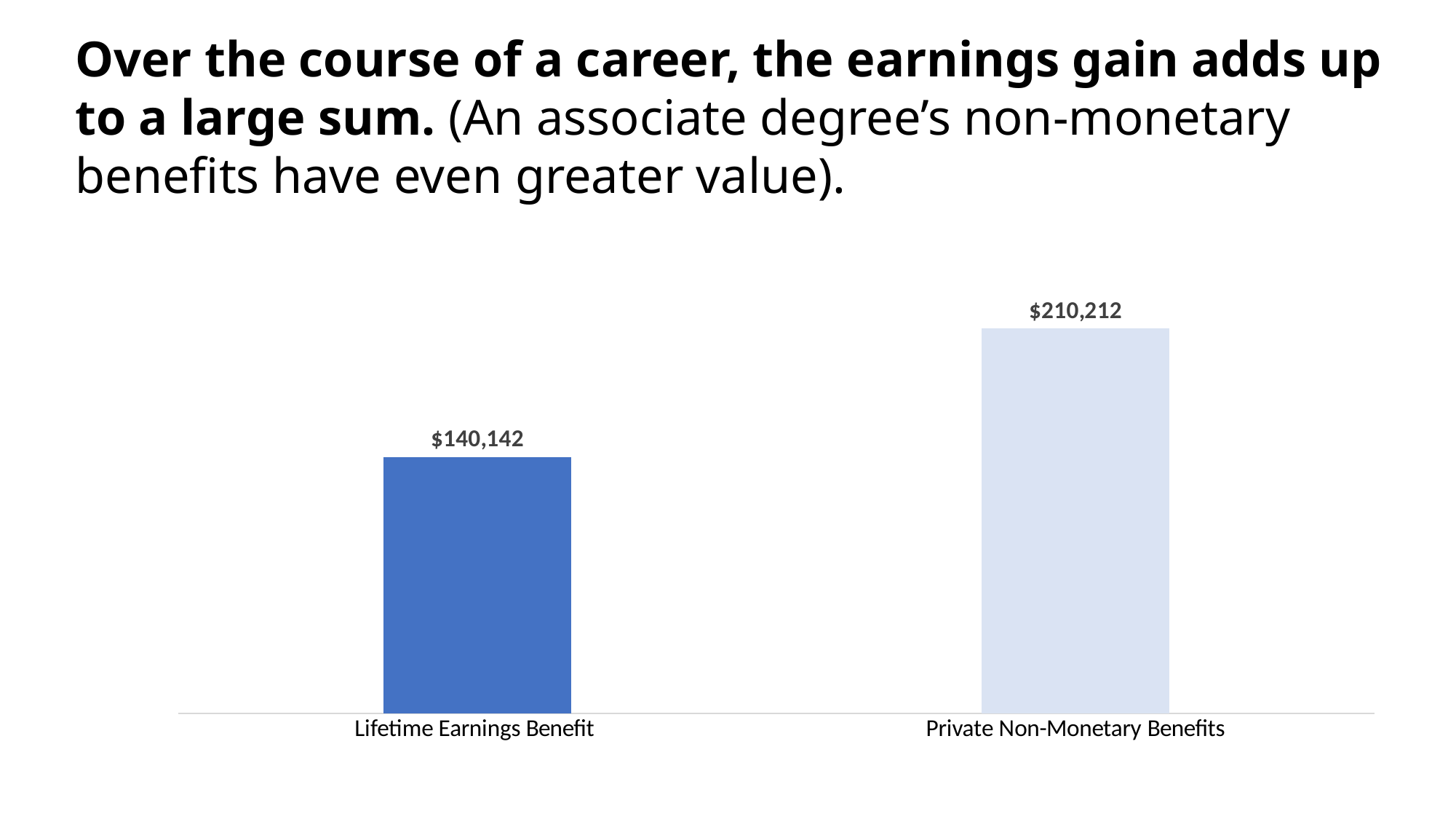
Do the values rise or fall from left to right across the categories? Rise Which category has the highest value? Private Non-Monetary Benefits What is the value for Private Non-Monetary Benefits? $210,212 How many categories are shown in the chart? 2 Which bar is drawn in the darker blue colour? Lifetime Earnings Benefit What kind of chart is shown on the slide? Bar chart What is the difference between the Private Non-Monetary Benefits value and the Lifetime Earnings Benefit value? $70,070 What is the total of the two values shown in the chart? $350,354 What is the value for Lifetime Earnings Benefit? $140,142 Which is larger, Lifetime Earnings Benefit or Private Non-Monetary Benefits? Private Non-Monetary Benefits Which category has the lowest value? Lifetime Earnings Benefit